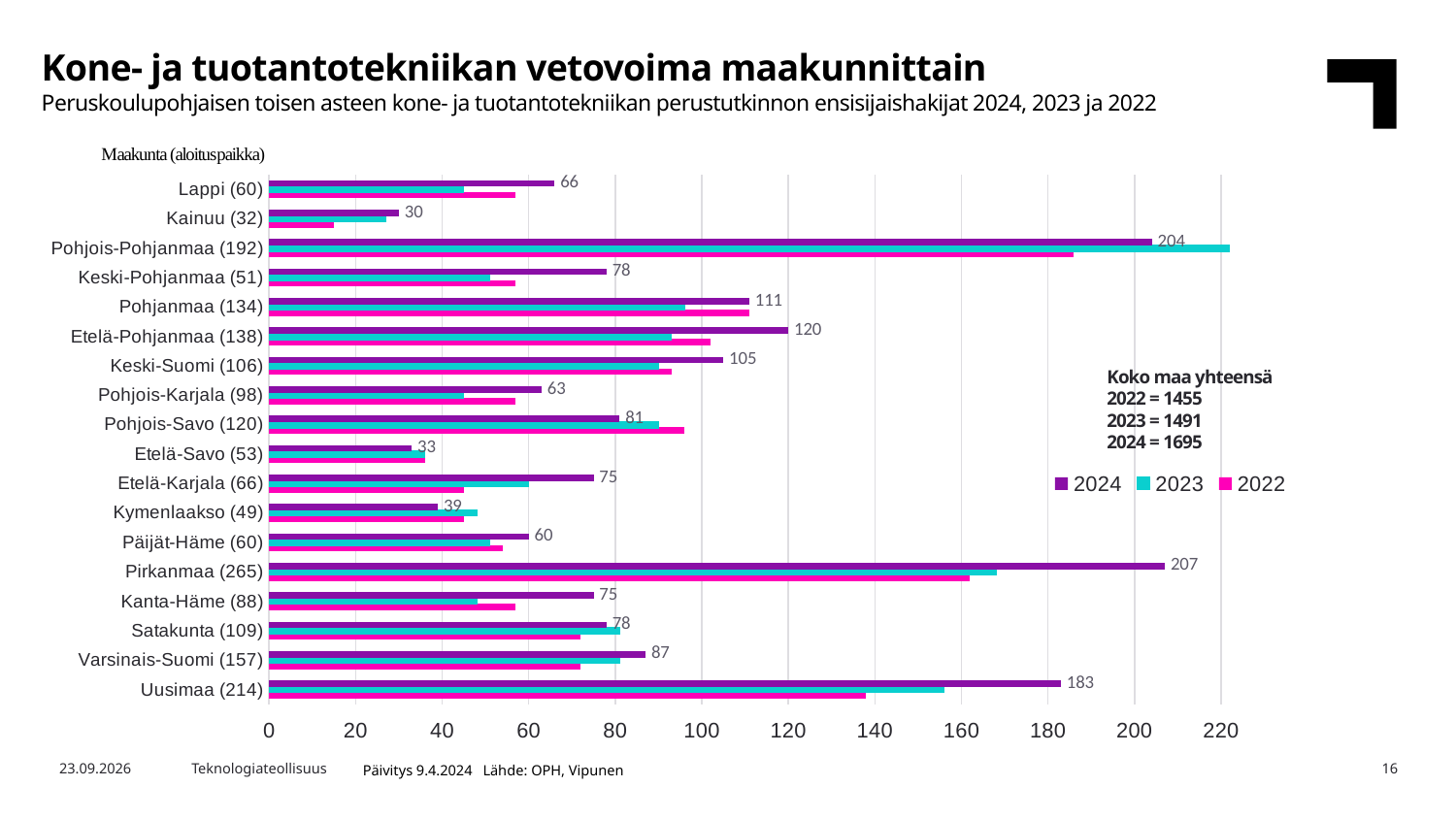
How many series does the legend list? 3 What kind of chart is shown on the slide? Bar chart What is the difference between the 2024 values for Pirkanmaa (265) and Uusimaa (214)? 24 What is the 2024 value for Pirkanmaa (265)? 207 Is the 2023 value for Pohjois-Pohjanmaa (192) greater or less than 200? greater Which region has the highest 2024 value? Pirkanmaa (265) Which has the larger 2024 value, Pirkanmaa (265) or Pohjois-Pohjanmaa (192)? Pirkanmaa (265) How many regions are shown on the chart? 18 Is the 2022 value for Kainuu (32) greater or less than 20? less What is the 2024 value for Kainuu (32)? 30 What is the 2024 value for Uusimaa (214)? 183 Which region has the lowest 2024 value? Kainuu (32)